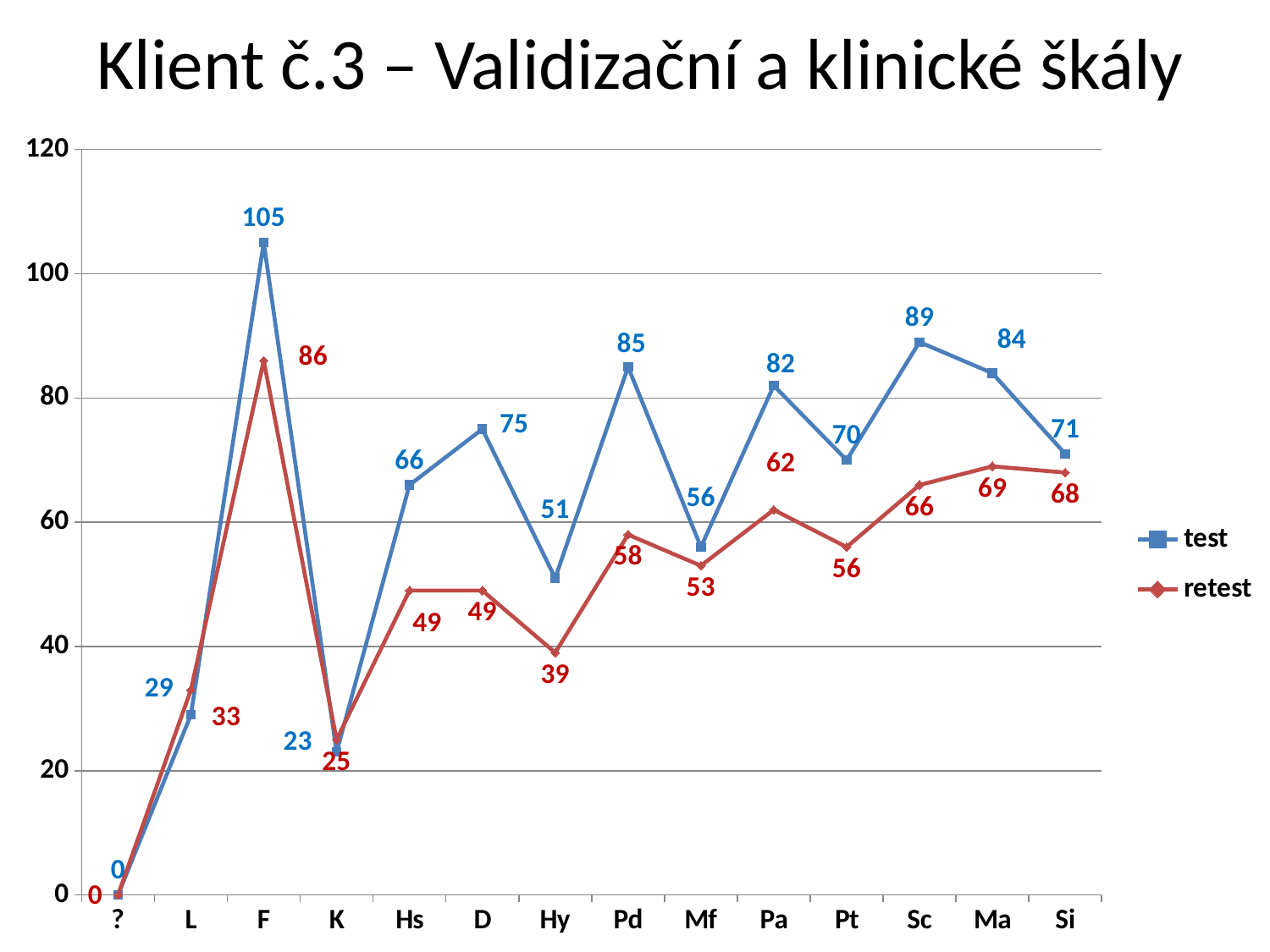
What is the retest value for the Hy scale? 39 What kind of chart is shown on the slide? line chart What is the difference between the test and retest values for the Pd scale? 27 How many series does the legend list? 2 Which scale has the highest test value? F What colour is the retest series line? red How many scales are shown on the x axis? 14 What is the title of the slide? Klient č.3 – Validizační a klinické škály Which scale has the lowest retest value? ? Which is larger for the L scale, the test value or the retest value? retest What is the retest value for the Sc scale? 66 What is the test value for the F scale? 105